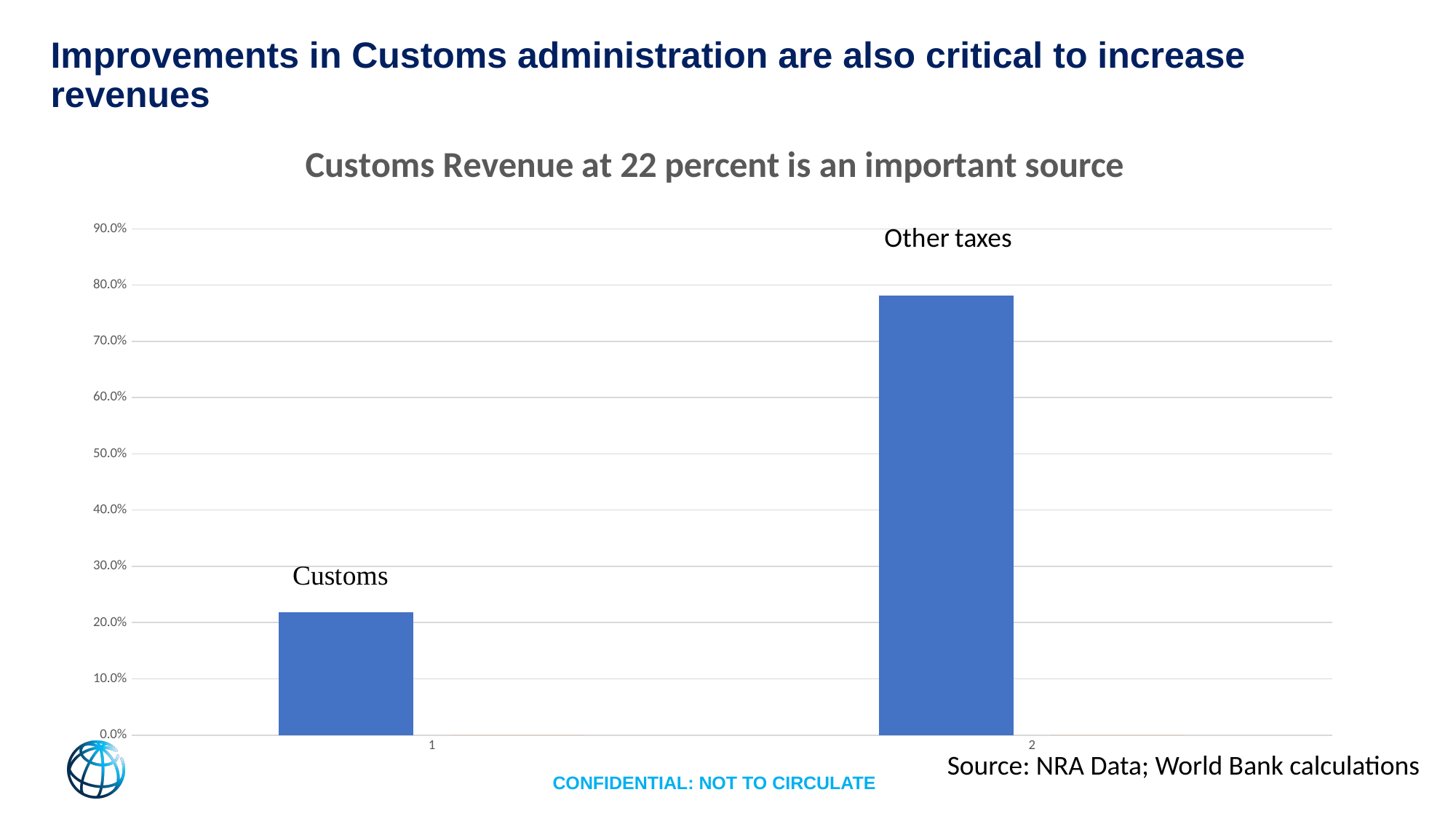
Which category has the lowest value in the chart? Customs What is the title of the chart? Customs Revenue at 22 percent is an important source What kind of chart is shown on the slide? bar chart What is the highest tick value shown on the vertical axis of the chart? 90.0% Is the value for Customs greater or less than 10.0%? greater Is the value for Other taxes greater or less than 80.0%? less Is the value for Customs greater or less than 30.0%? less Which category has the highest value in the chart? Other taxes Which is larger, the value for Customs or the value for Other taxes? Other taxes How many bars are plotted in the chart? 2